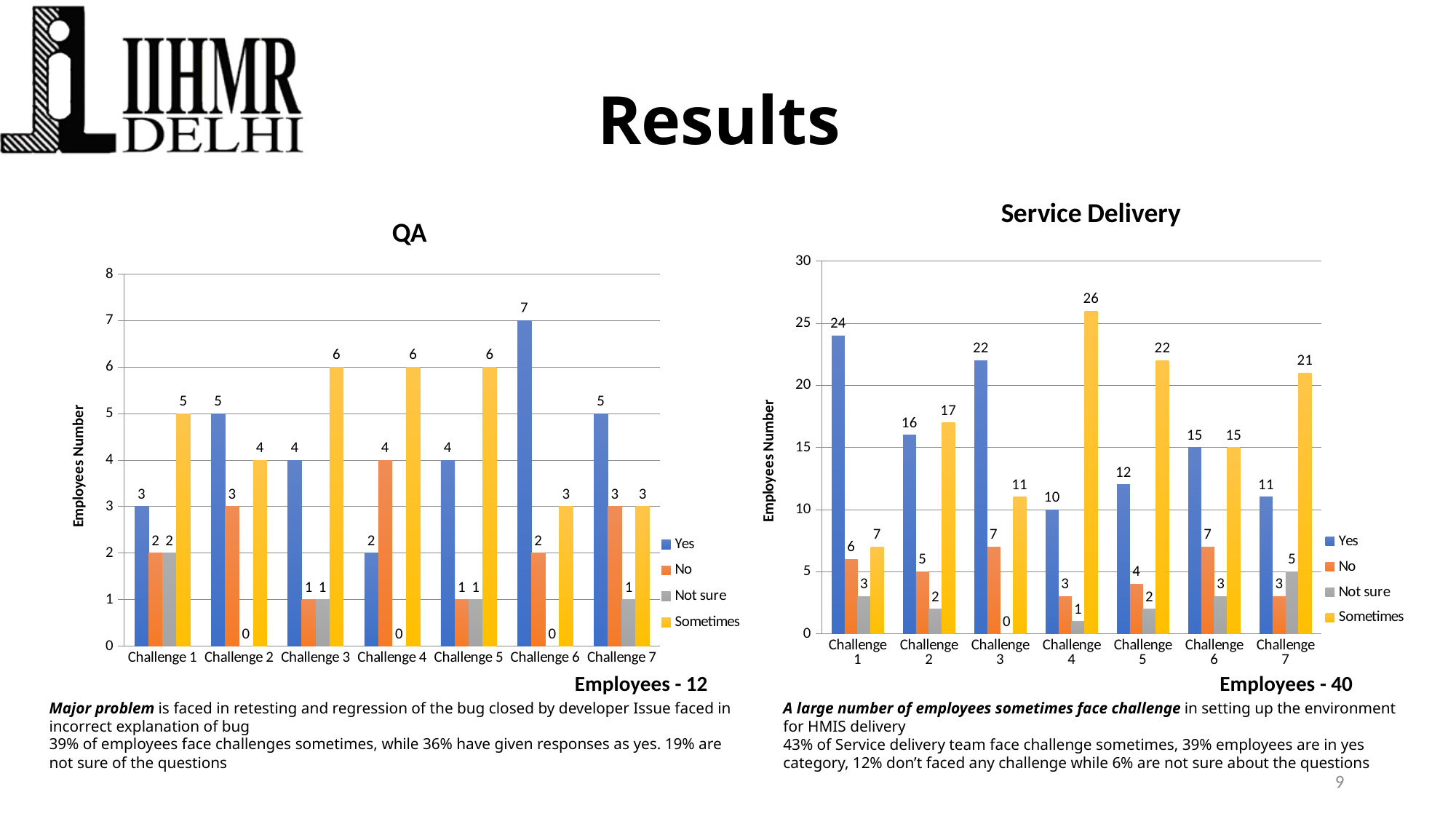
What is the y-axis label of the Service Delivery chart? Employees Number In the Service Delivery chart, which challenge has the highest Yes value? Challenge 1 What type of chart is the QA chart? Bar chart In the QA chart, which challenge has the lowest Yes value? Challenge 4 In the Service Delivery chart, what is the Not sure value for Challenge 7? 5 In the QA chart, what is the Yes value for Challenge 6? 7 How many challenge categories are shown on the x axis of the QA chart? 7 In the Service Delivery chart, what is the difference between the Yes and Sometimes values for Challenge 1? 17 How many series does the legend of the Service Delivery chart list? 4 In the QA chart, which is larger for Challenge 4: the No value or the Yes value? No In the Service Delivery chart, what is the Sometimes value for Challenge 4? 26 In the Service Delivery chart, is the Yes value for Challenge 3 greater or less than 20? greater